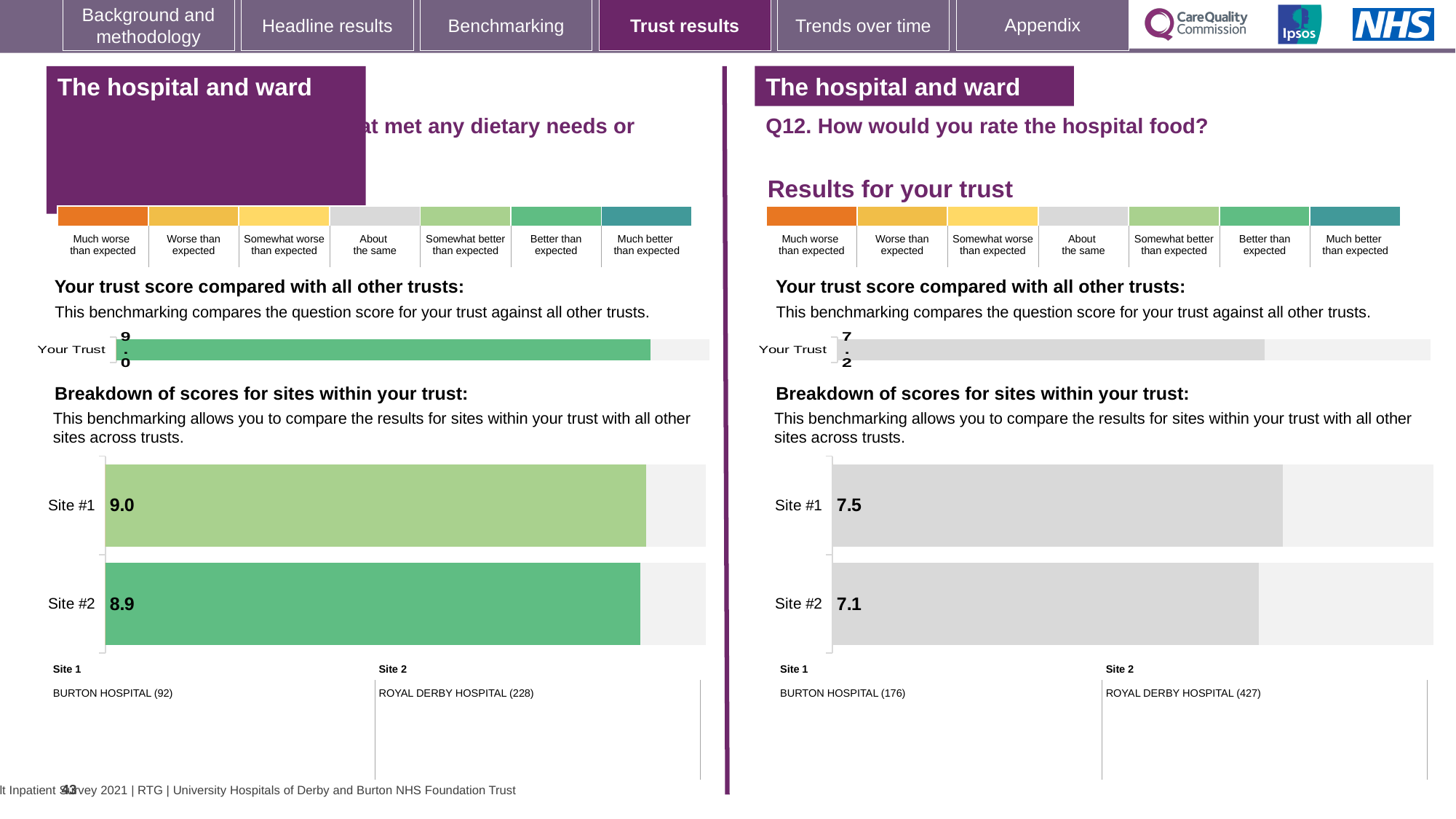
What type of chart is used for the site breakdown on the right-hand side (Q12)? Bar chart How many sites are shown in the right-hand site breakdown chart (Q12)? 2 On the right-hand chart (Q12, hospital food), what is the score for Site #2? 7.1 On the left-hand site breakdown chart, what is the score for Site #2? 8.9 On the right-hand site breakdown chart (Q12), what is the difference between the Site #1 and Site #2 scores? 0.4 On the left-hand site breakdown chart, what is the score for Site #1? 9.0 On the right-hand 'Your trust score compared with all other trusts' chart (Q12), what is the score for Your Trust? 7.2 On the left-hand site breakdown chart, what is the difference between the Site #1 and Site #2 scores? 0.1 On the left-hand 'Your trust score compared with all other trusts' chart, what is the score for Your Trust? 9.0 On the right-hand chart (Q12, hospital food), what is the score for Site #1? 7.5 On the right-hand site breakdown chart (Q12), which site has the higher score? Site #1 On the right-hand site breakdown chart (Q12), which hospital is listed as Site 2? ROYAL DERBY HOSPITAL (427)